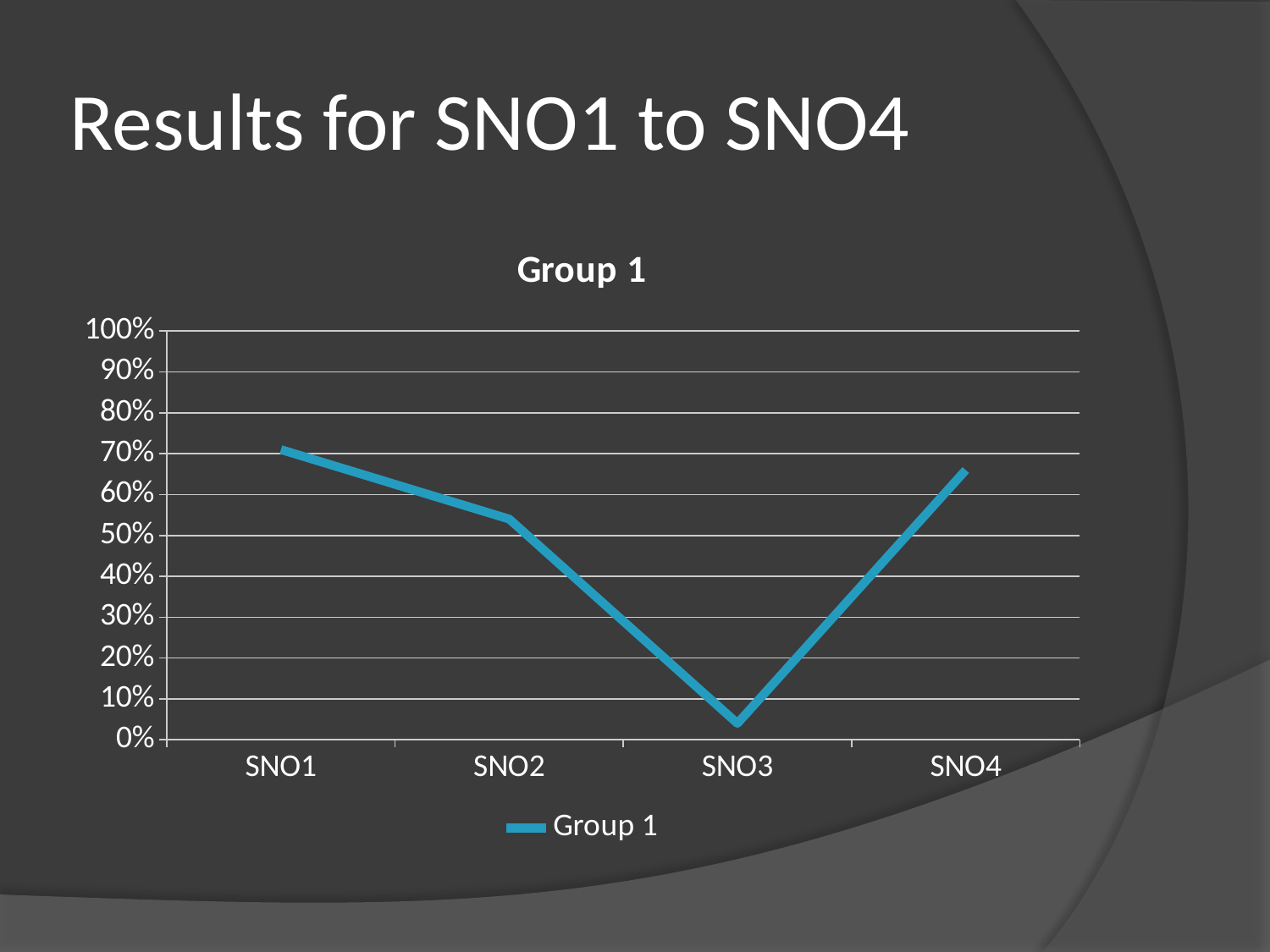
Which category has the highest value? SNO1 What kind of chart is shown on the slide? line chart Is the value for SNO2 greater or less than 40%? greater Is the value for SNO3 greater or less than 10%? less Is the value for SNO4 greater or less than 50%? greater How many categories are plotted along the x axis? 4 What is the title of the chart? Group 1 How many series does the legend list? 1 Which has the larger value, SNO2 or SNO4? SNO4 Do the values rise or fall from SNO1 to SNO3? fall Which category has the lowest value? SNO3